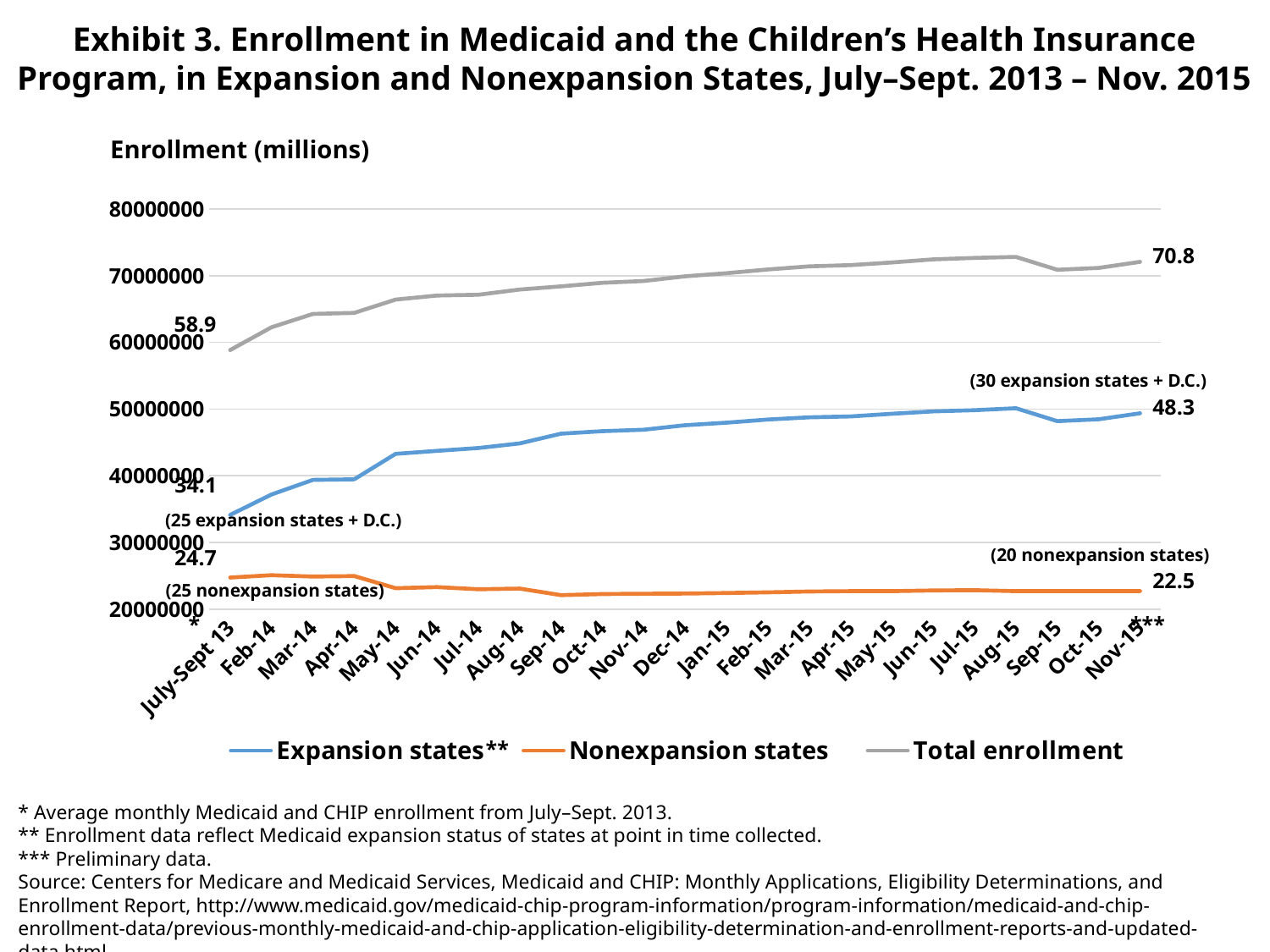
What is the Total enrollment value labeled for Nov-15? 70.8 What is the Expansion states value labeled for Nov-15? 48.3 Which series has the higher value in Nov-15, Expansion states or Nonexpansion states? Expansion states By how much did Total enrollment increase from July-Sept 13 (58.9) to Nov-15 (70.8)? 11.9 What is the Nonexpansion states value labeled for July-Sept 13? 24.7 How many time periods are shown on the x axis? 23 What type of chart is shown on the slide? line chart Does the Nonexpansion states line rise or fall from July-Sept 13 to Nov-15? fall What is the difference between the Expansion states values for Nov-15 (48.3) and July-Sept 13 (34.1)? 14.2 How many series does the legend list? 3 What is the Total enrollment value labeled for July-Sept 13? 58.9 Is the Total enrollment value for Aug-15 greater or less than 70000000? greater